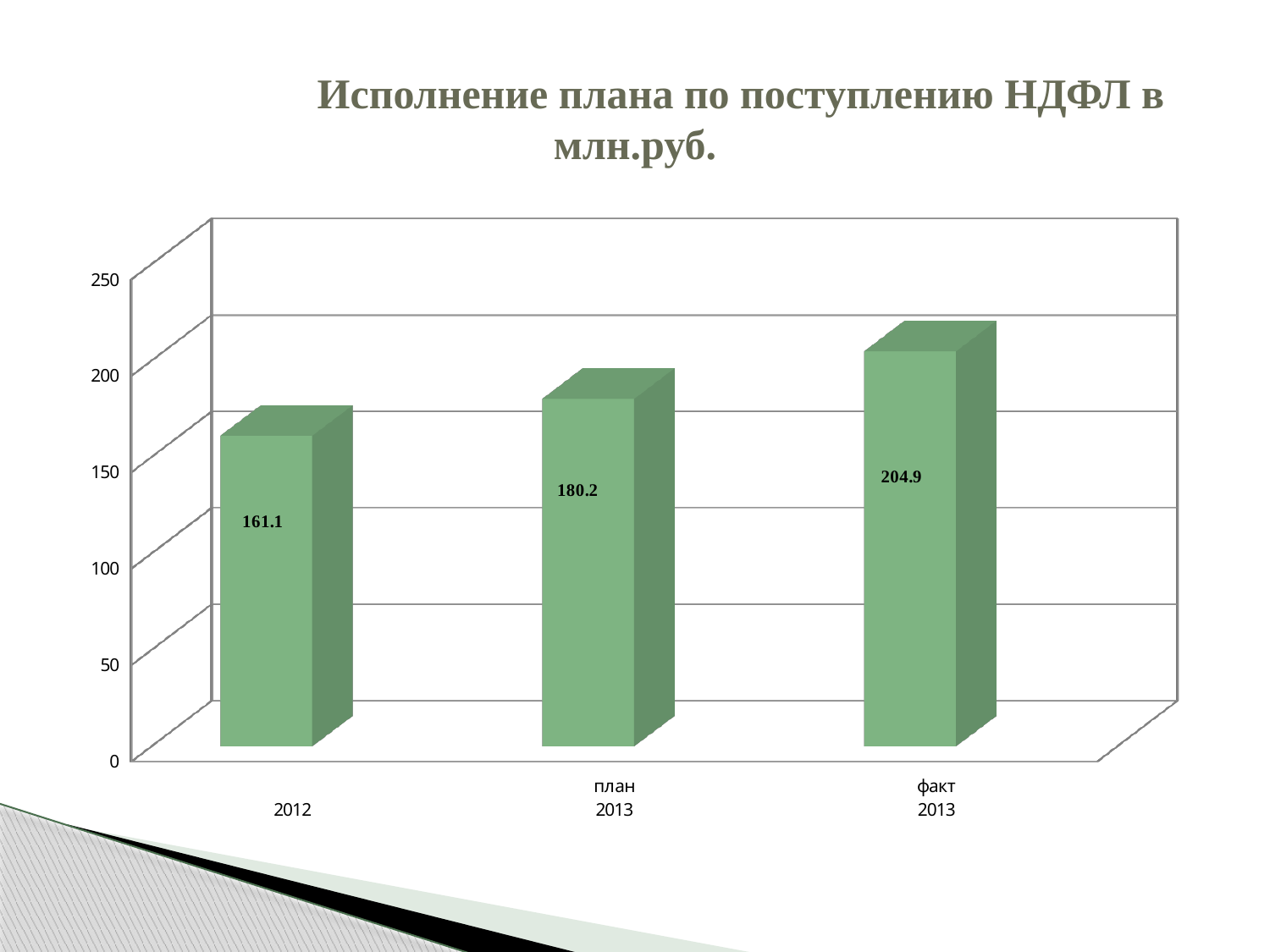
Which category has the highest value? факт 2013 What is the title of the chart? Исполнение плана по поступлению НДФЛ в млн.руб. What is the difference between план 2013 and 2012? 19.1 What kind of chart is shown on the slide? bar chart What is the value for план 2013? 180.2 Which category has the lowest value? 2012 What is the value for 2012? 161.1 How many bars are shown in the chart? 3 What is the difference between факт 2013 and план 2013? 24.7 Is the value for факт 2013 greater or less than 200? greater Which is larger, the value for 2012 or the value for план 2013? план 2013 What is the value for факт 2013? 204.9